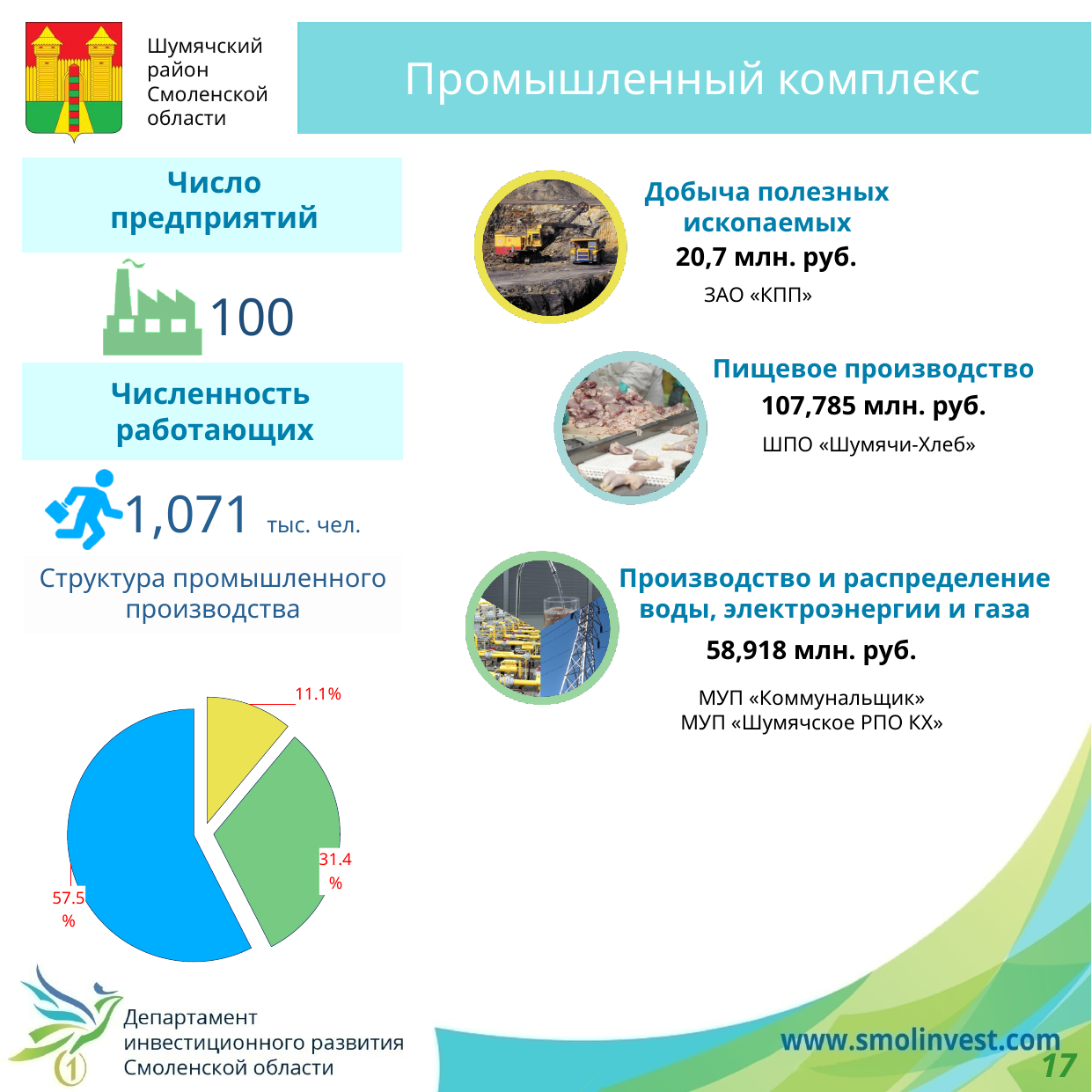
What percentage is shown for the yellow slice of the pie chart? 11.1% What percentage is shown for the green slice of the pie chart? 31.4% What percentage is shown for the blue slice of the pie chart? 57.5% Which colour slice of the pie chart is the smallest? yellow What is the title shown above the pie chart? Структура промышленного производства Is the blue slice of the pie chart greater or less than 50%? greater What kind of chart is shown under the heading "Структура промышленного производства"? pie chart In the pie chart, which is larger: the green slice or the yellow slice? green What is the difference in percentage points between the blue slice and the green slice of the pie chart? 26.1 Which colour slice of the pie chart is the largest? blue How many slices does the pie chart have? 3 What is the difference in percentage points between the green slice and the yellow slice of the pie chart? 20.3